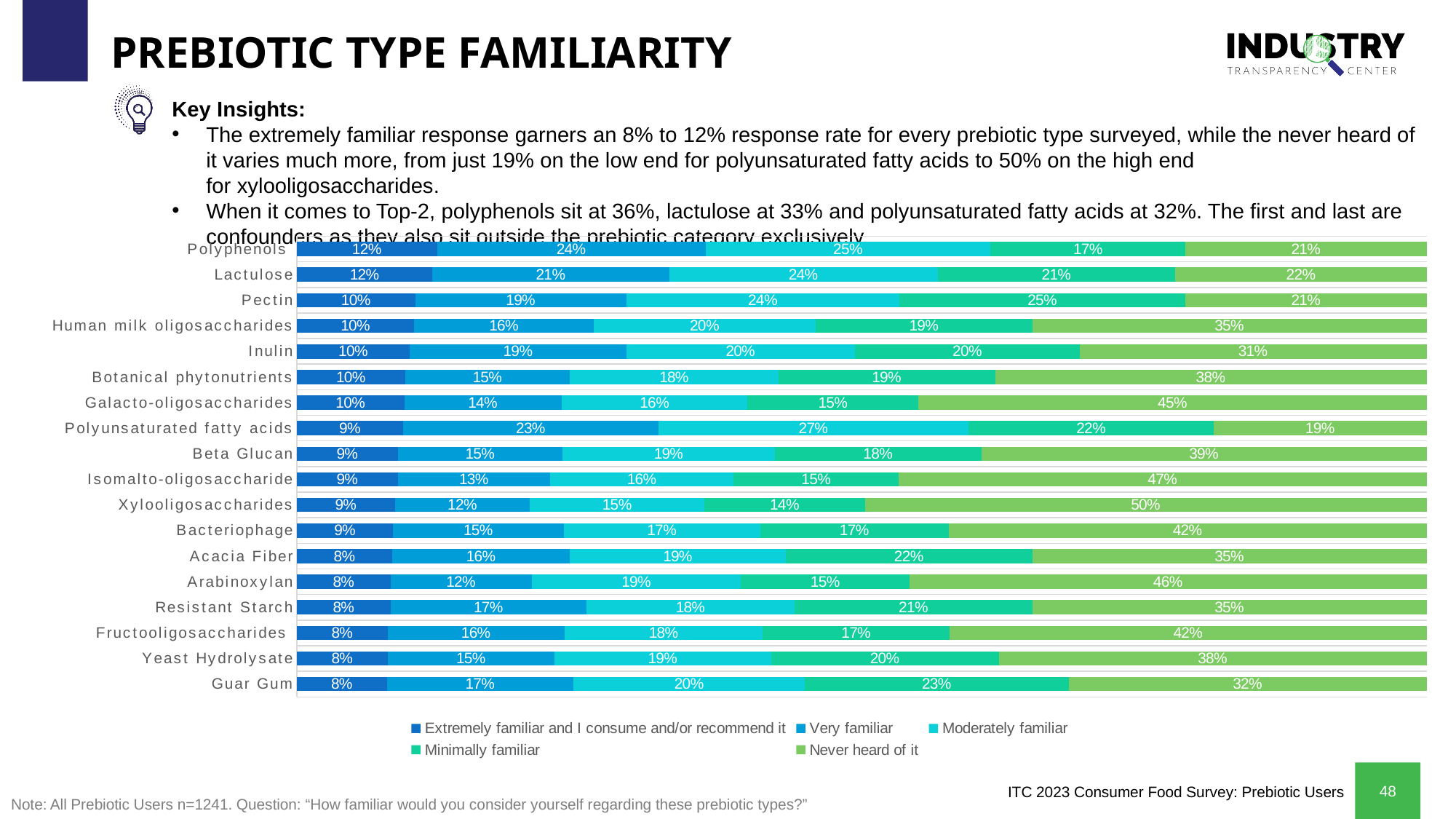
How many prebiotic types are listed on the chart? 18 What is the 'Very familiar' value for Polyphenols? 24% Which prebiotic type has the highest 'Never heard of it' value? Xylooligosaccharides Which prebiotic type has the highest 'Moderately familiar' value? Polyunsaturated fatty acids Which prebiotic type has the lowest 'Never heard of it' value? Polyunsaturated fatty acids What is the 'Minimally familiar' value for Guar Gum? 23% Which has a larger 'Never heard of it' value, Bacteriophage or Acacia Fiber? Bacteriophage What percentage of respondents said they had never heard of Xylooligosaccharides? 50% What kind of chart is shown on the slide? Stacked bar chart What is the total of the segments in the Lactulose bar? 100% How many series does the legend list? 5 What is the difference between the 'Never heard of it' values for Xylooligosaccharides and Polyunsaturated fatty acids? 31 percentage points